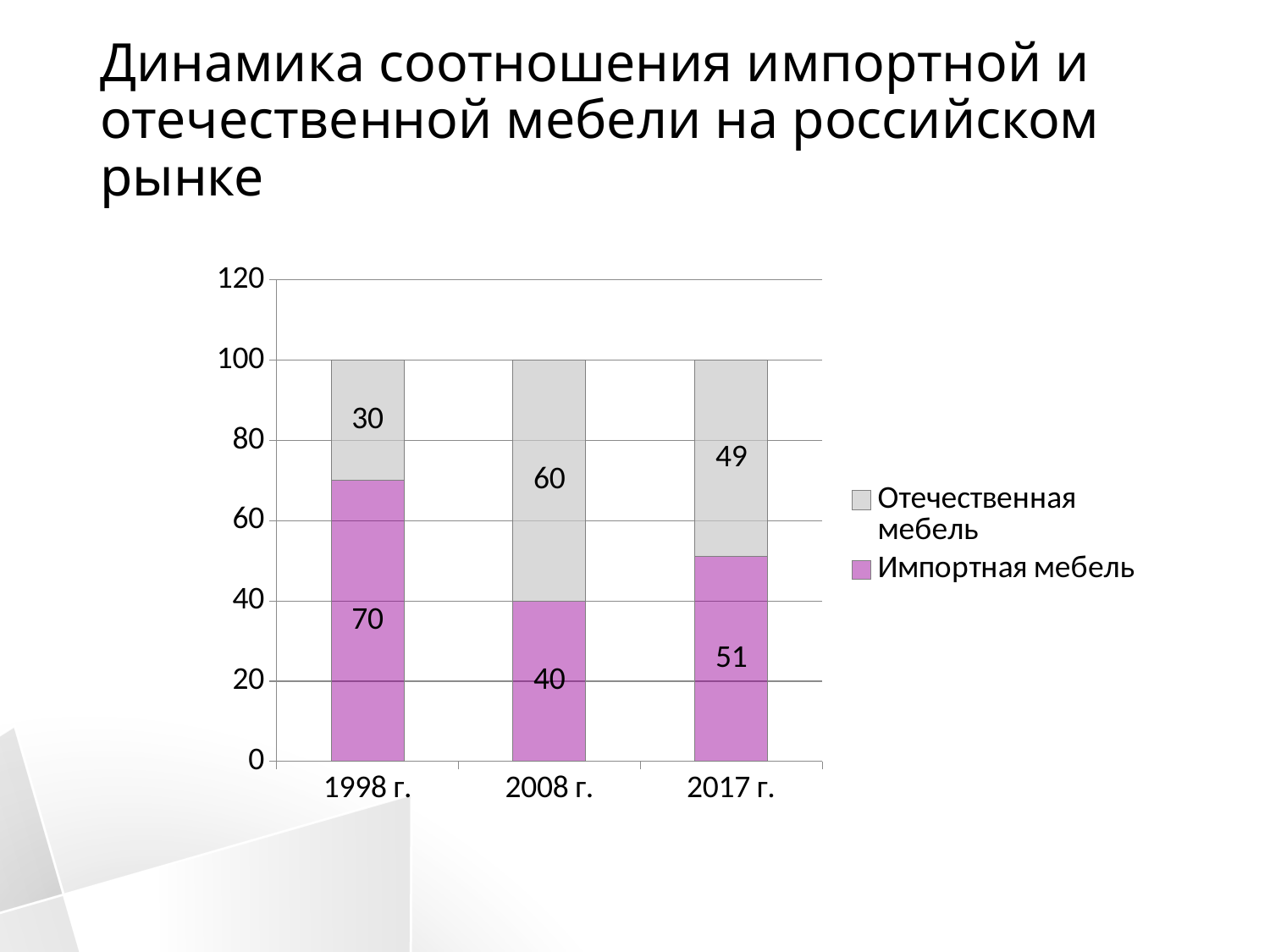
In which year is the value for Отечественная мебель the lowest? 1998 г. How many series does the legend list? 2 How many years are shown on the x axis? 3 What is the value for Отечественная мебель in 2008 г.? 60 What is the difference between the Импортная мебель values for 1998 г. and 2008 г.? 30 In which year is the value for Импортная мебель the highest? 1998 г. What is the value for Отечественная мебель in 2017 г.? 49 What is the total of the stacked bar for 2017 г.? 100 Which is larger in 2008 г.: Отечественная мебель or Импортная мебель? Отечественная мебель What kind of chart is shown on the slide? Stacked bar chart What is the value for Импортная мебель in 2017 г.? 51 What is the value for Импортная мебель in 1998 г.? 70